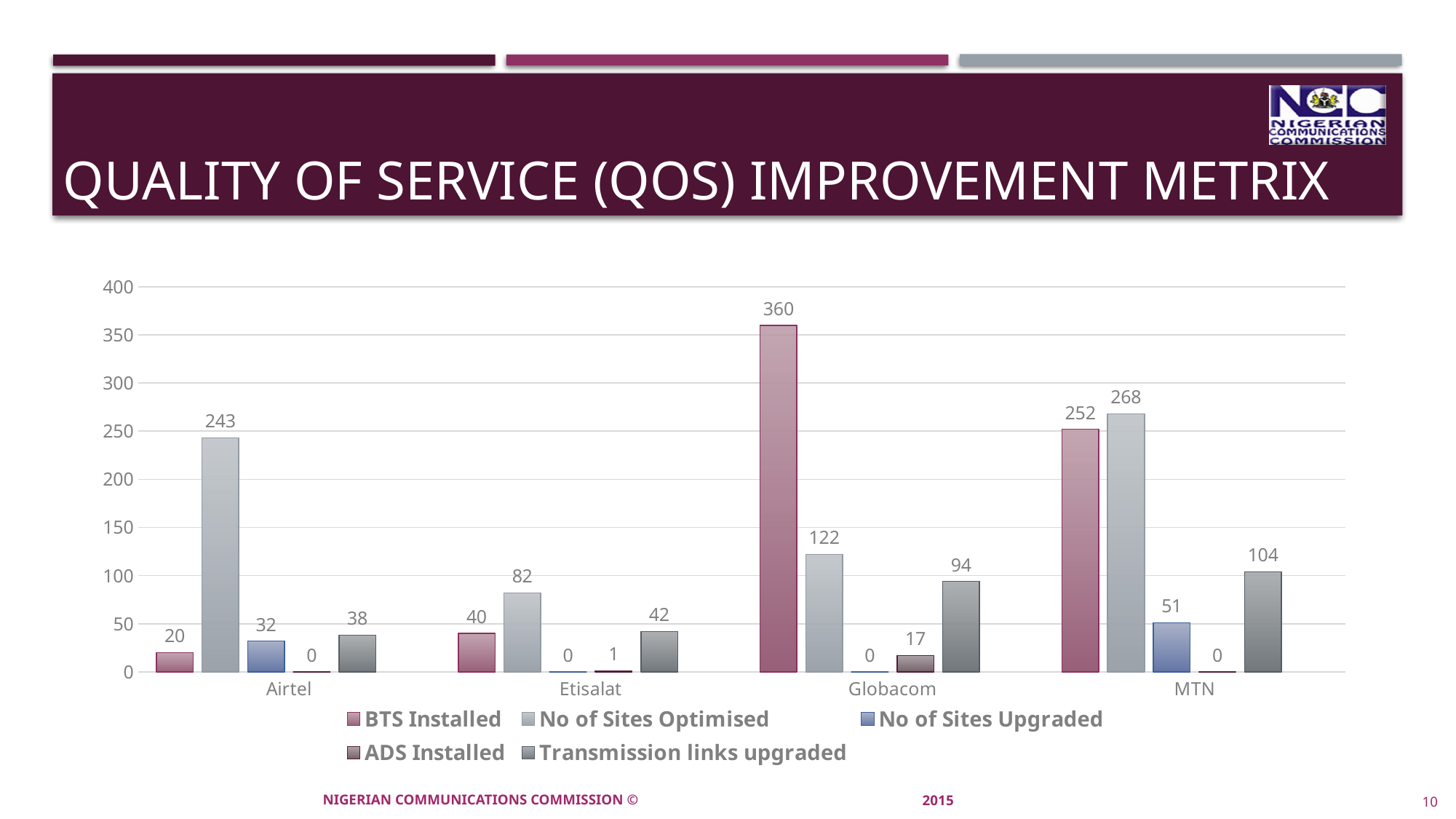
Which operator has the lowest No of Sites Optimised value? Etisalat What is the value of Transmission links upgraded for MTN? 104 How many series does the legend list? 5 Which is larger for MTN: BTS Installed or No of Sites Optimised? No of Sites Optimised What kind of chart is shown on the slide? Bar chart What is the title of the slide containing the chart? QUALITY OF SERVICE (QOS) IMPROVEMENT METRIX Which operator has the highest BTS Installed value? Globacom What is the value of No of Sites Optimised for Airtel? 243 How many operators are shown on the x axis? 4 What is the value of BTS Installed for Globacom? 360 What is the value of ADS Installed for Globacom? 17 What is the difference between No of Sites Optimised for MTN and for Globacom? 146